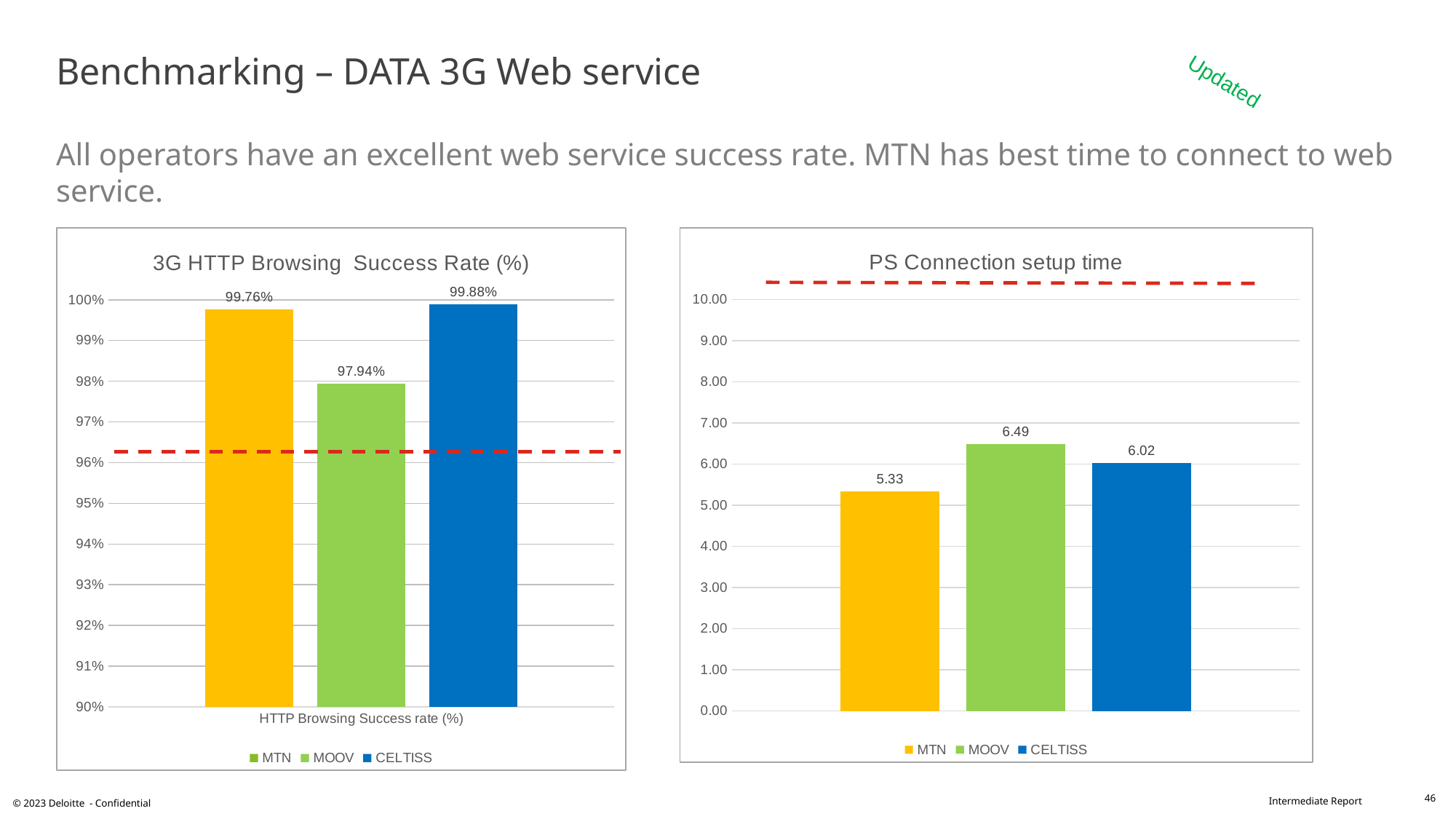
In the 'PS Connection setup time' chart, is the value for CELTISS larger or smaller than the value for MTN? larger In the 'PS Connection setup time' chart, what is the value for MOOV? 6.49 What kind of chart is the 'PS Connection setup time' chart? bar chart In the 'PS Connection setup time' chart, what colour is the CELTISS bar? blue In the '3G HTTP Browsing Success Rate (%)' chart, which operator has the lowest success rate? MOOV In the 'PS Connection setup time' chart, what is the difference between the MOOV and MTN values? 1.16 In the '3G HTTP Browsing Success Rate (%)' chart, what is the value for MOOV? 97.94% In the 'PS Connection setup time' chart, what is the value for MTN? 5.33 In the '3G HTTP Browsing Success Rate (%)' chart, what is the difference between the MTN and MOOV values? 1.82% In the '3G HTTP Browsing Success Rate (%)' chart, what is the value for CELTISS? 99.88% In the '3G HTTP Browsing Success Rate (%)' chart, how many series does the legend list? 3 In the 'PS Connection setup time' chart, which operator has the highest value? MOOV